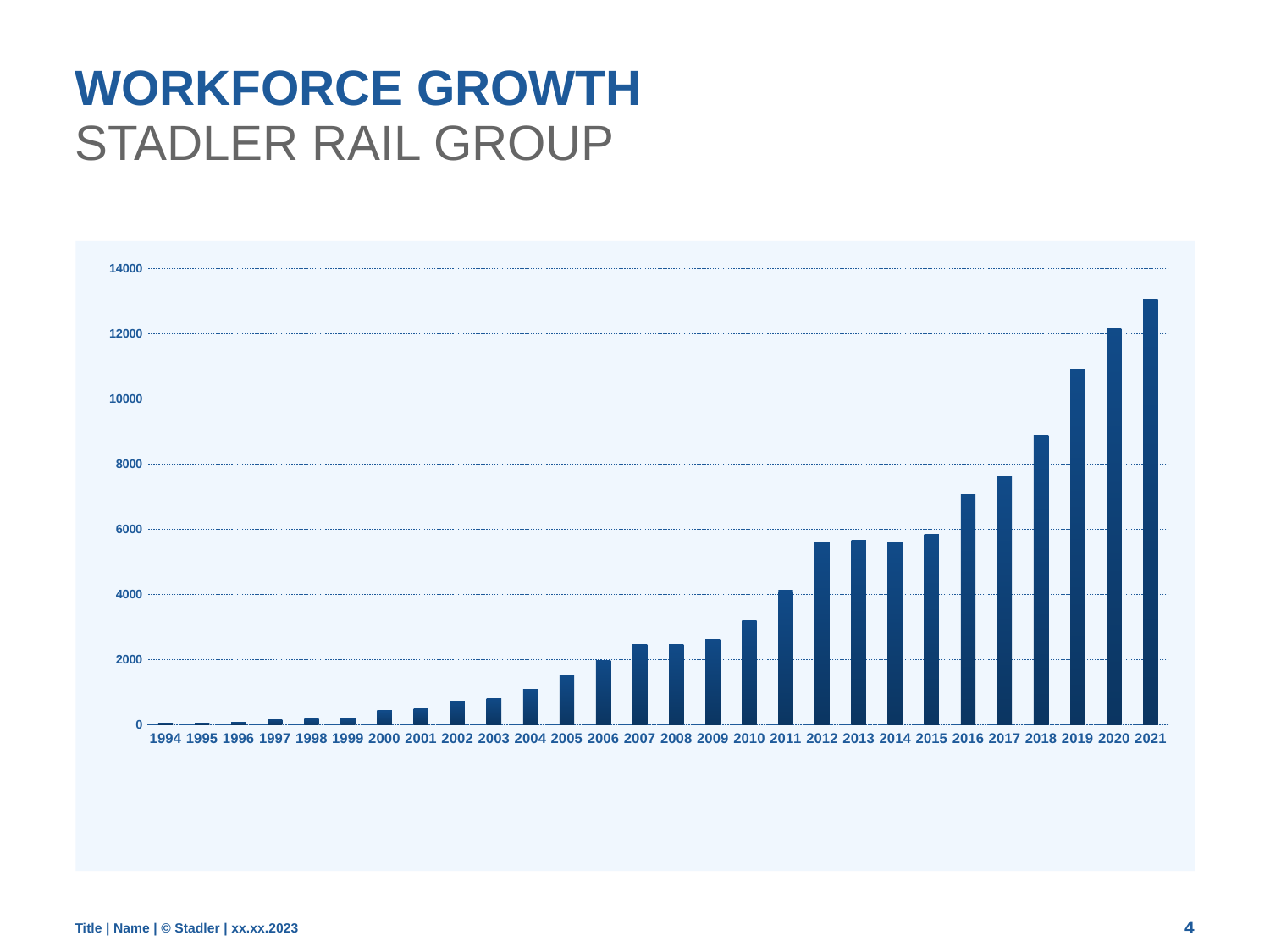
Is the value for 2010 greater or less than 4000? less Do the values generally rise or fall from 1994 to 2021? rise Which year has the highest bar in the chart? 2021 Which year has the larger value, 2012 or 2016? 2016 How many years are shown on the x axis of the chart? 28 What kind of chart is shown on the slide? bar chart Is the value for 2019 greater or less than 10000? greater Is the value for 2017 greater or less than 8000? less What is the title of the slide containing the chart? WORKFORCE GROWTH STADLER RAIL GROUP Which year has the larger value, 2017 or 2018? 2018